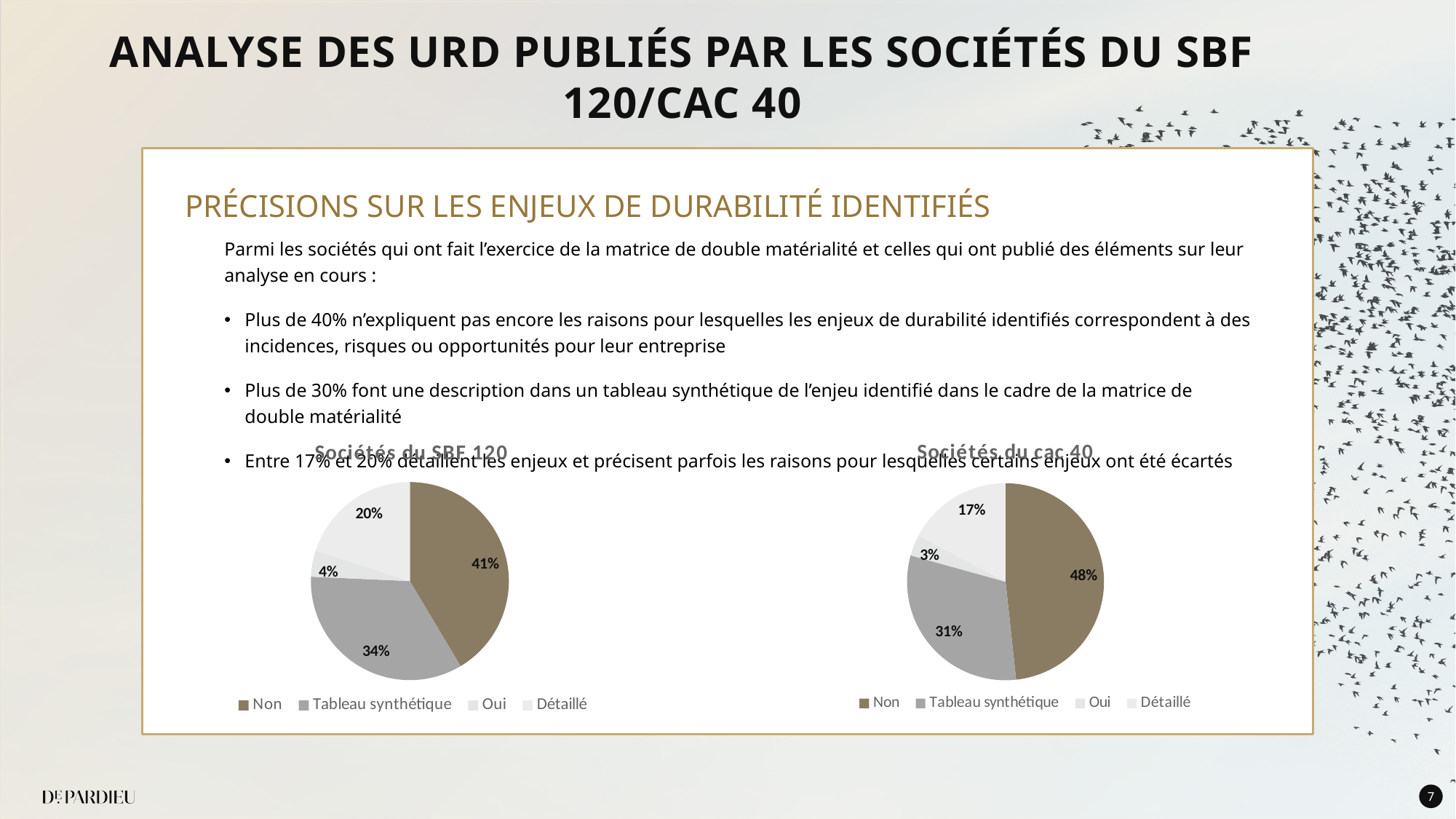
In the 'Sociétés du cac 40' pie chart, what share is labelled for the 'Tableau synthétique' slice? 31% In the 'Sociétés du cac 40' pie chart, which category has the smallest slice? Oui What is the difference between the 'Non' share in the 'Sociétés du cac 40' chart and the 'Non' share in the 'Sociétés du SBF 120' chart? 7 percentage points How many slices does the 'Sociétés du cac 40' pie chart have? 4 How many entries does the legend of the 'Sociétés du cac 40' chart list? 4 In the 'Sociétés du cac 40' pie chart, what share is labelled for the 'Oui' slice? 3% In the 'Sociétés du SBF 120' pie chart, what share is labelled for the 'Non' slice? 41% In the 'Sociétés du SBF 120' pie chart, what share is labelled for the 'Détaillé' slice? 20% Which is larger in the 'Sociétés du SBF 120' pie chart: the 'Tableau synthétique' slice or the 'Détaillé' slice? Tableau synthétique What type of chart is used for 'Sociétés du SBF 120'? Pie chart In the 'Sociétés du SBF 120' pie chart, which category has the largest slice? Non What is the title of the pie chart on the right side of the slide? Sociétés du cac 40